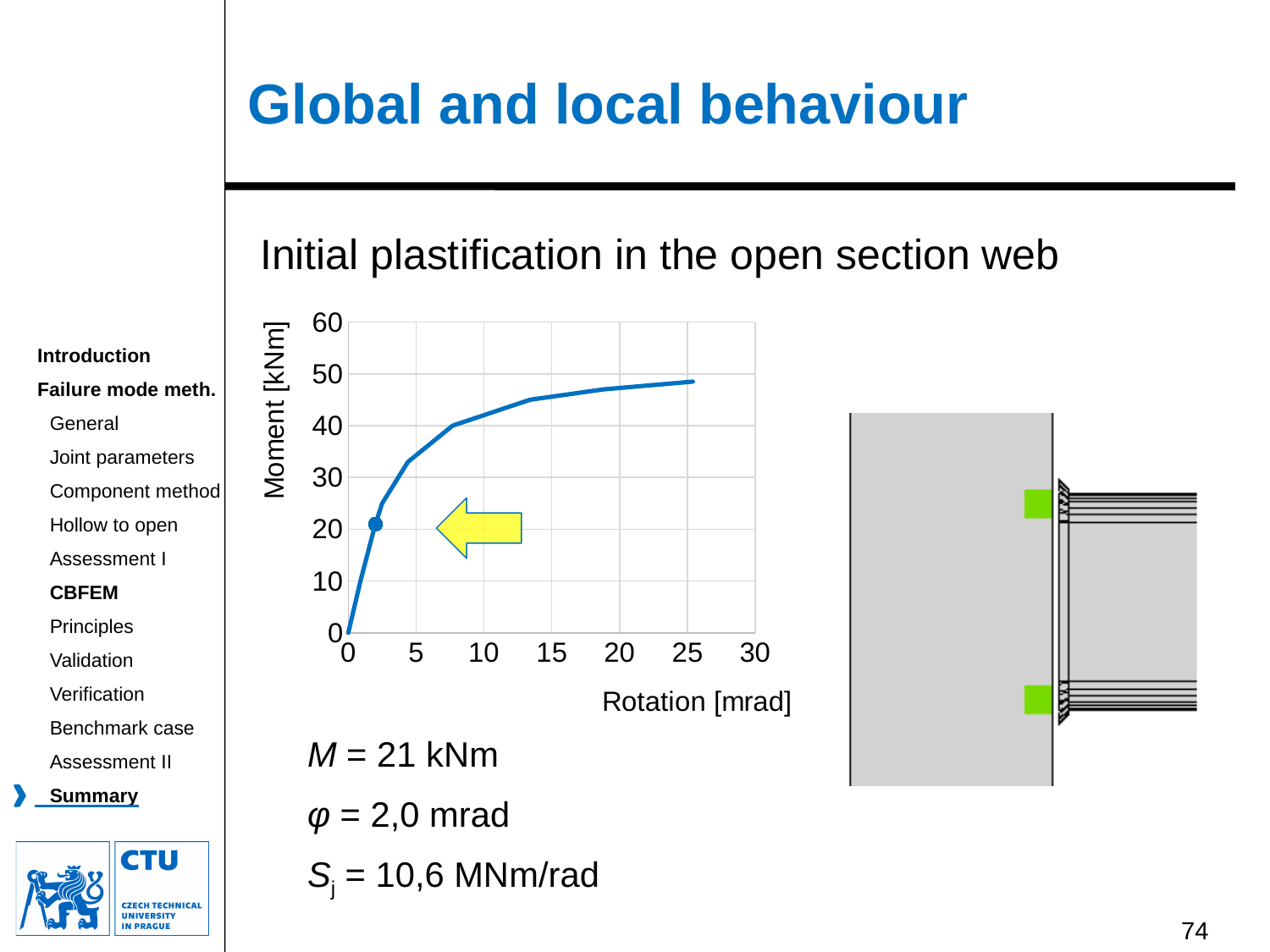
What is the rotation φ at the marked point on the curve? 2,0 mrad Is the moment at a rotation of 5 mrad greater or less than 30 kNm? greater How many curves are plotted on the chart? 1 What is the maximum value shown on the vertical axis of the chart? 60 Does the moment rise or fall as the rotation increases along the x axis? rise What is the label of the horizontal axis of the chart? Rotation [mrad] What is the moment M at the marked point on the curve? 21 kNm Is the moment at a rotation of 25 mrad greater or less than 40 kNm? greater What is the label of the vertical axis of the chart? Moment [kNm] Is the moment at a rotation of 10 mrad greater or less than 50 kNm? less What kind of chart is shown on the slide? line chart